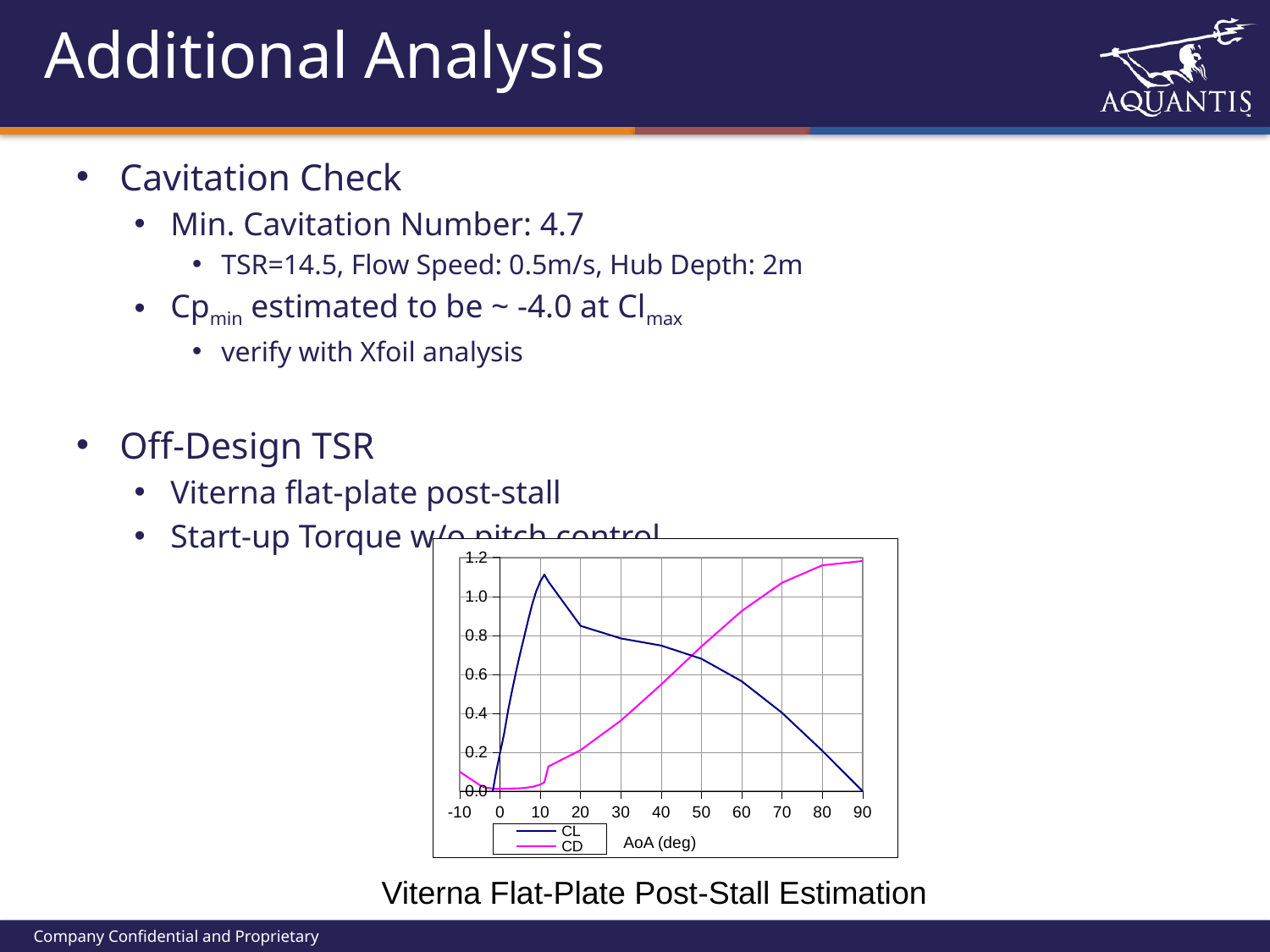
At an AoA of 30 degrees, which series has the larger value, CL or CD? CL At an AoA of 70 degrees, which series has the larger value, CL or CD? CD What kind of chart is shown on the slide? line chart Is the CD value at an AoA of 20 degrees greater or less than 0.4? less Does the CD series rise or fall as AoA increases from 20 to 90 degrees? rise Is the CL value at an AoA of 80 degrees greater or less than 0.4? less Does the CL series rise or fall as AoA increases from 20 to 90 degrees? fall What are the two series named in the chart's legend? CL and CD How many series does the chart's legend list? 2 What is the label of the chart's x axis? AoA (deg) Is the CD value at an AoA of 80 degrees greater or less than 1.0? greater